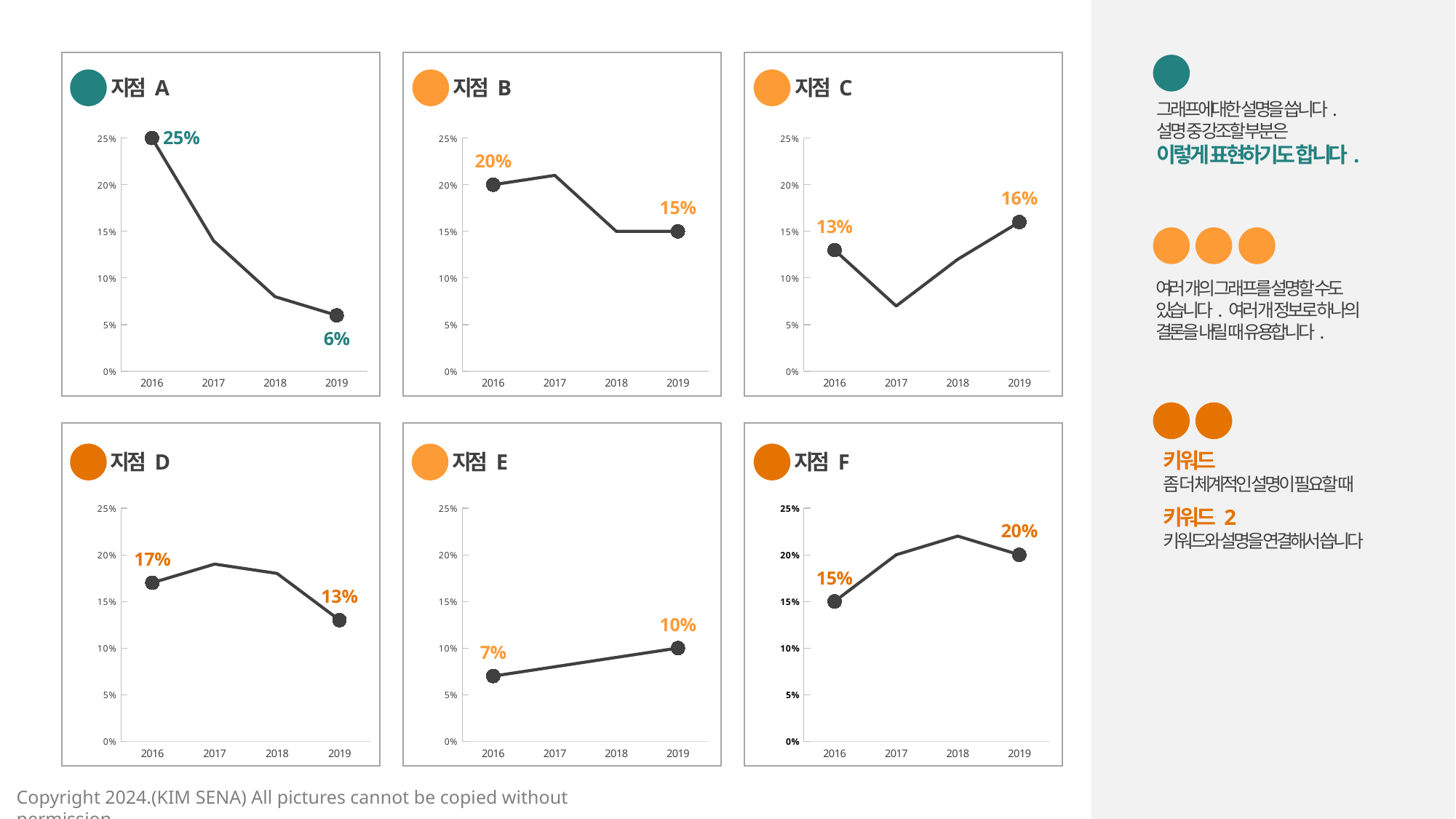
In the 지점 B chart, what is the value for 2019? 15% In the 지점 A chart, what is the value for 2016? 25% In the 지점 E chart, is the value for 2017 greater or less than 10%? less What kind of chart is the 지점 F chart? line chart In the 지점 D chart, which is larger, the value for 2016 or the value for 2019? 2016 How many charts are shown on the slide? 6 In the 지점 F chart, what is the difference between the 2019 value and the 2016 value? 5% In the 지점 A chart, do the values rise or fall from 2016 to 2019? fall In the 지점 C chart, what is the value for 2016? 13% How many years are shown on the x axis of the 지점 C chart? 4 In the 지점 A chart, is the value for 2017 greater or less than 10%? greater In the 지점 A chart, what is the value for 2019? 6%